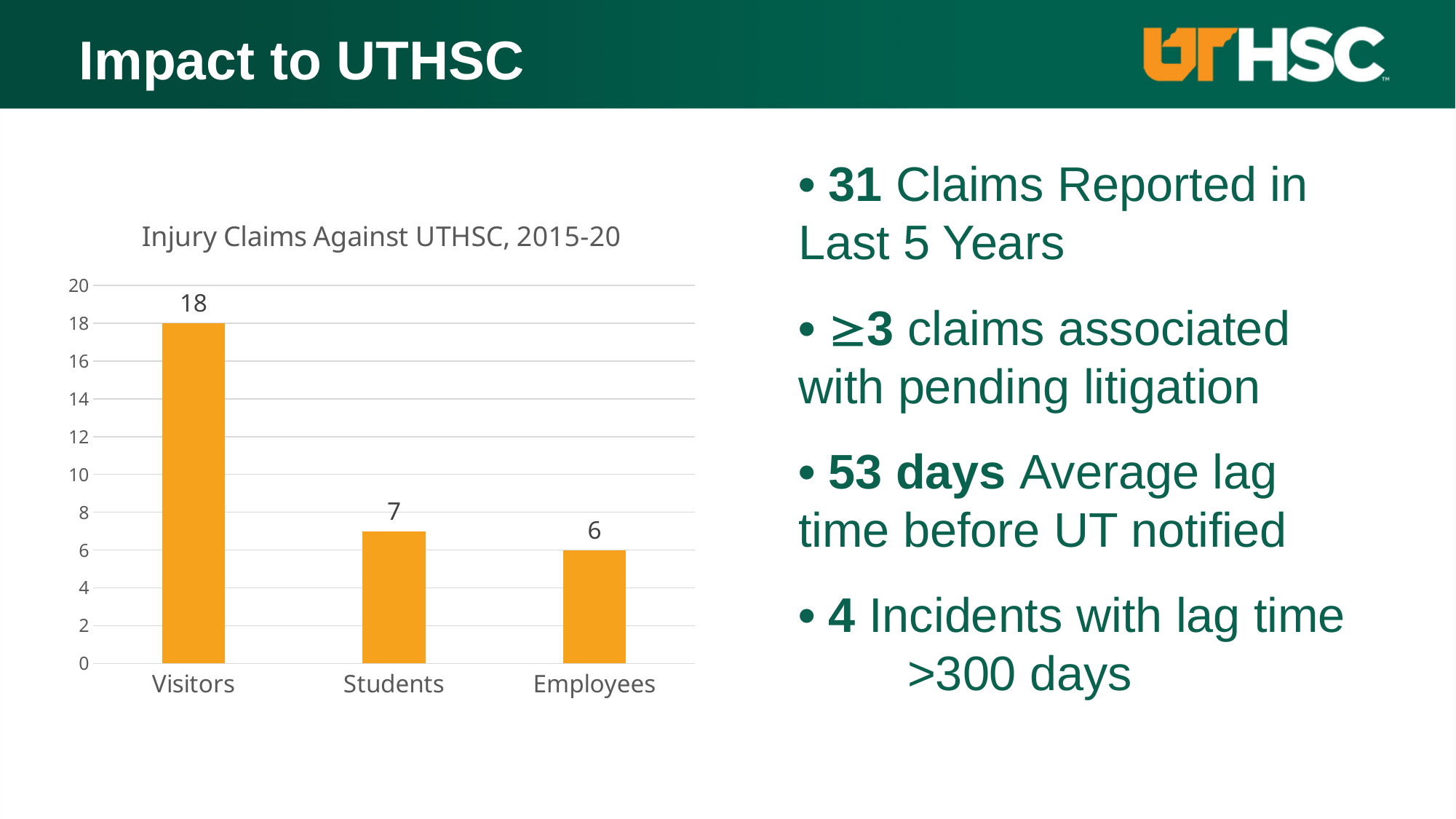
How many categories are shown in the chart? 3 What is the title of the chart? Injury Claims Against UTHSC, 2015-20 Which category has the lowest number of injury claims? Employees What is the value for Visitors in the chart? 18 What kind of chart is shown on the slide? Bar chart What is the difference between the values for Students and Employees? 1 Which is larger, the value for Visitors or the value for Employees? Visitors What is the difference between the values for Visitors and Students? 11 What is the value for Employees in the chart? 6 What is the value for Students in the chart? 7 Is the value for Visitors greater or less than 10? greater Which category has the highest number of injury claims? Visitors